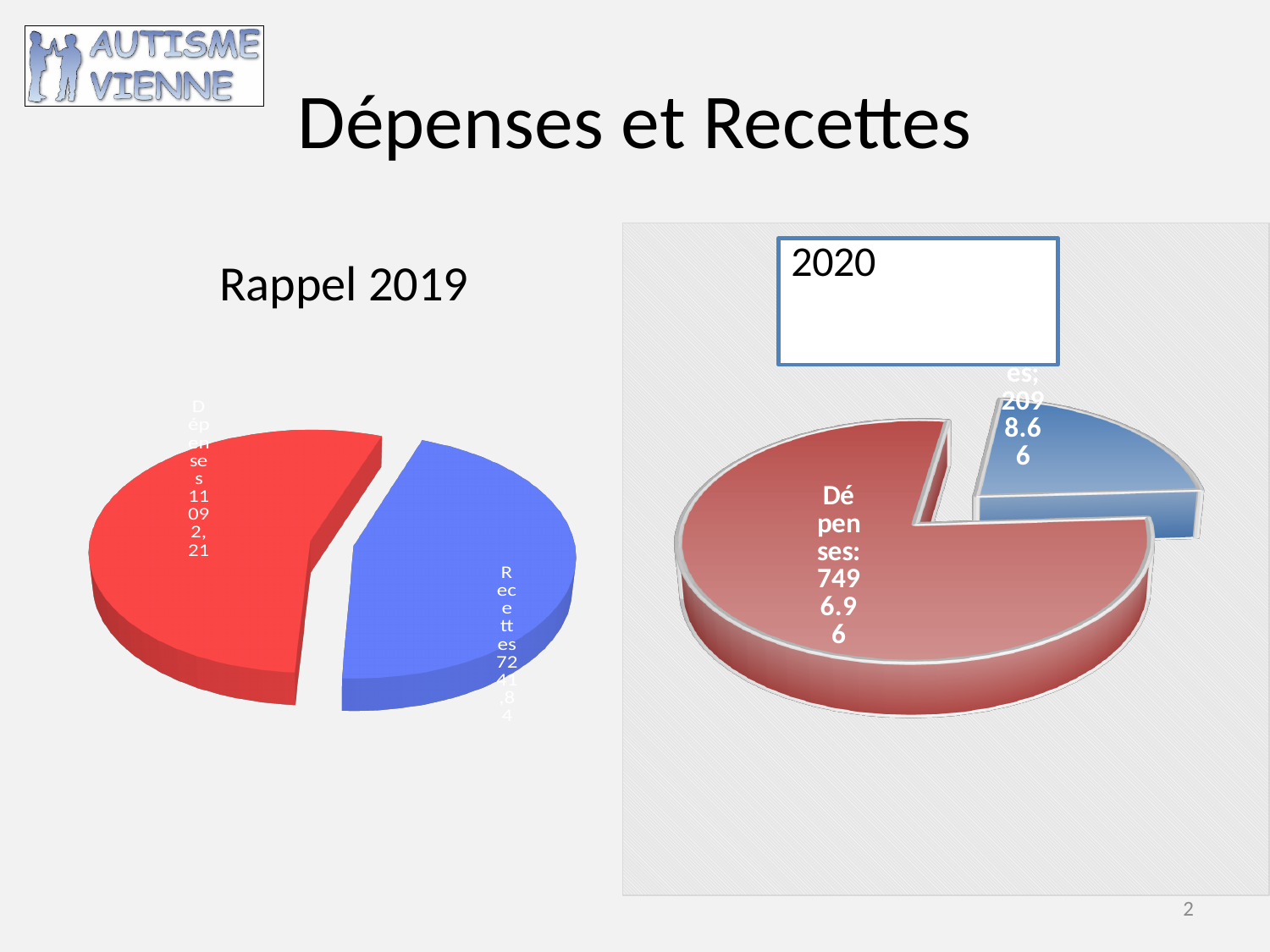
How many slices does the 2020 pie chart have? 2 In the 2020 chart, which slice is the largest? Dépenses In the Rappel 2019 chart, what is the value for Dépenses? 11092,21 In the 2020 chart, what colour is the Dépenses slice? red How many pie charts are shown on the slide? 2 In the 2020 chart, what is the value shown on the blue slice? 2098.66 What is the title of the slide containing the charts? Dépenses et Recettes What kind of chart is the Rappel 2019 chart? pie chart In the 2020 chart, what is the difference between the Dépenses value and the blue slice value? 5398.30 In the Rappel 2019 chart, which is larger, Dépenses or Recettes? Dépenses In the 2020 chart, what is the value for Dépenses? 7496.96